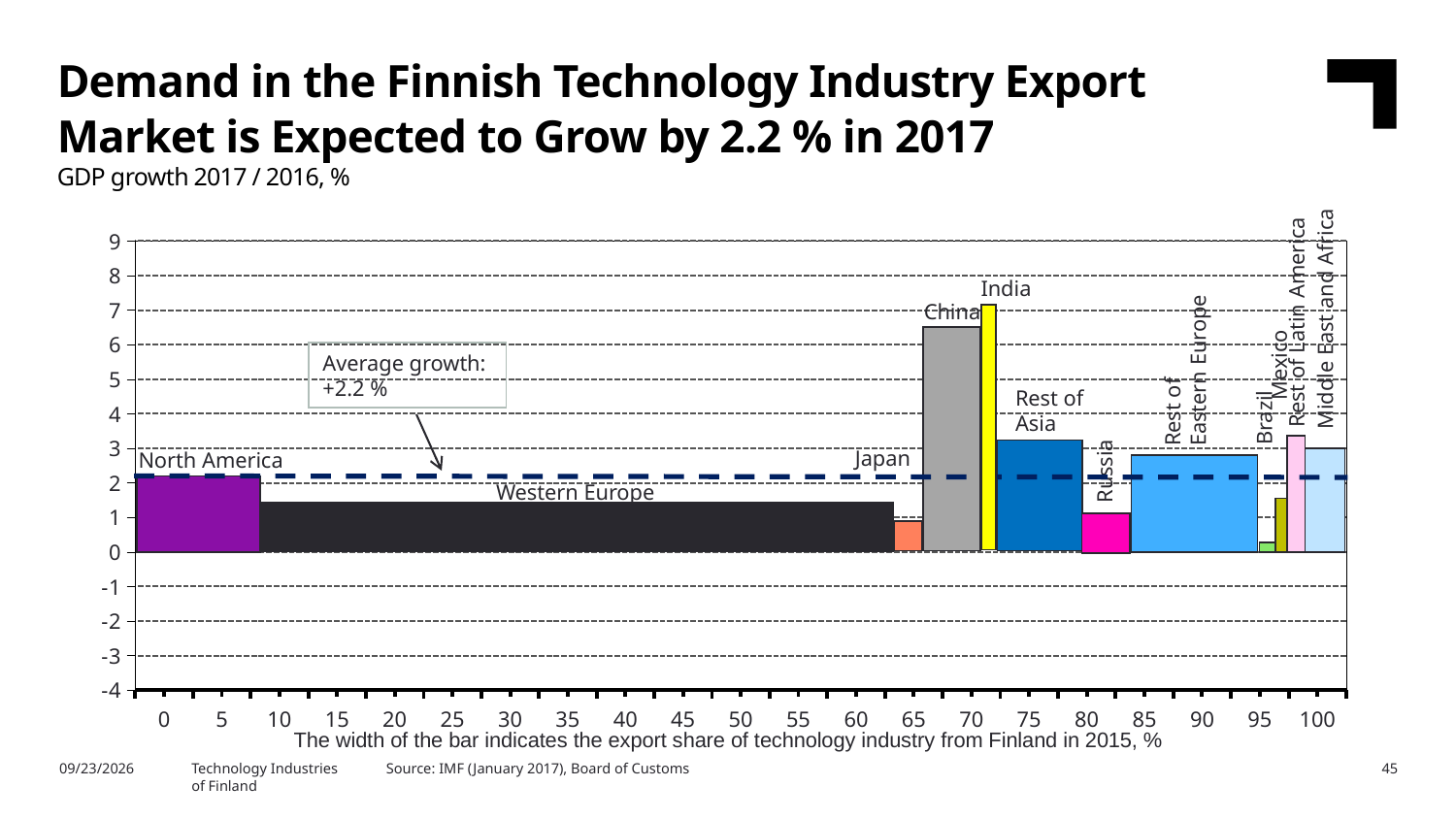
Which region has the highest GDP growth in the chart? India Which has the higher GDP growth, China or Japan? China Which region has the lowest GDP growth in the chart? Brazil According to the note below the x axis, what does the width of each bar indicate? The export share of technology industry from Finland in 2015, % Is the value for Brazil greater or less than 1? less What average growth value is indicated by the dashed line in the chart? +2.2 % Is the value for Middle East and Africa greater or less than 2? greater What type of chart is shown on the slide? bar chart How many regions are shown as bars in the chart? 12 Is the value for Western Europe greater or less than 2? less Which has the higher GDP growth, North America or Western Europe? North America